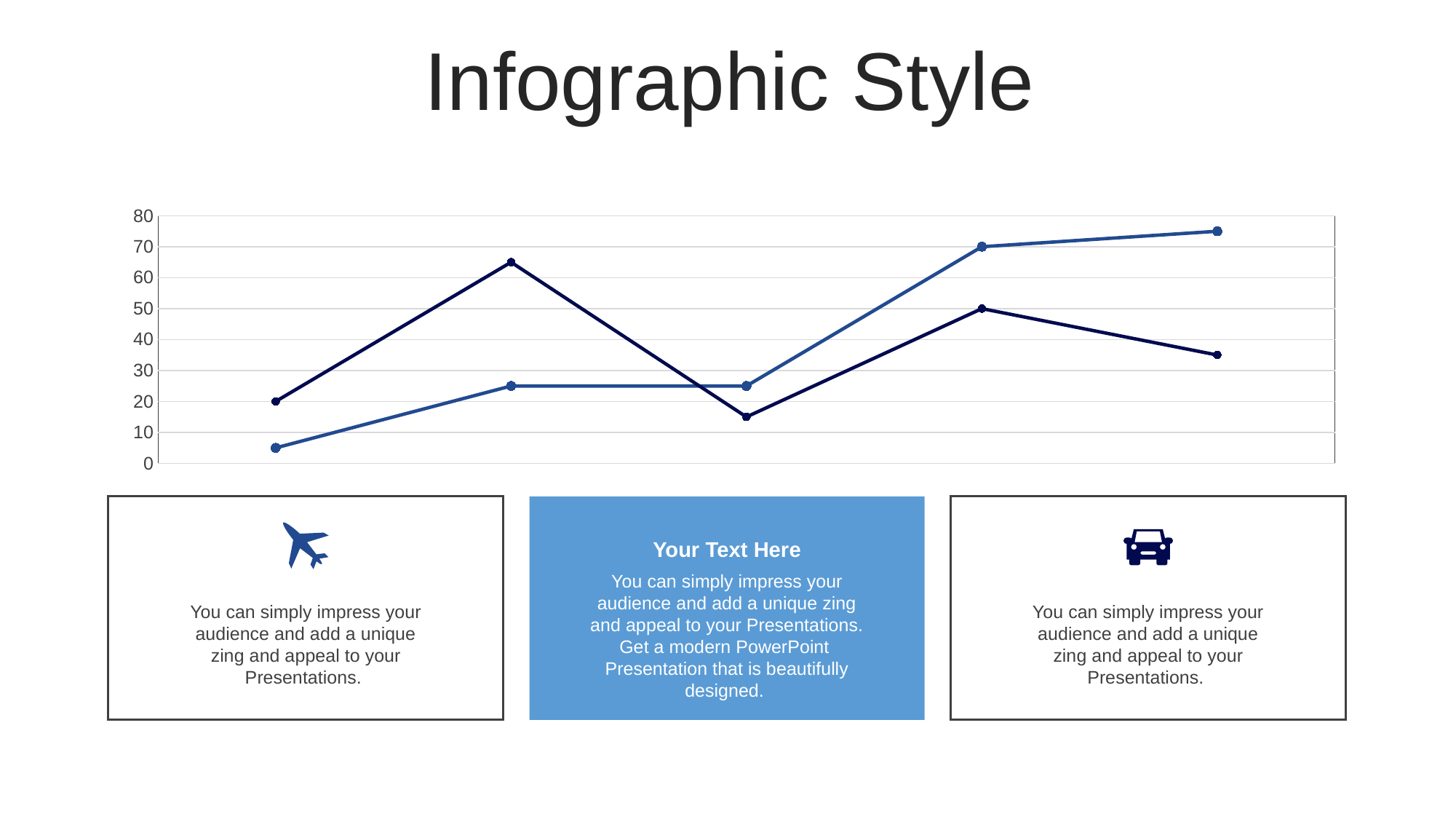
At the last (fifth) point, which line is higher, the dark navy line or the lighter blue line? the lighter blue line Which point on the lighter blue line is the highest? the fifth (last) point What is the value of the first point on the dark navy line? 20 Is the value of the second point on the dark navy line greater or less than 60? greater What is the value of the fourth point on the dark navy line? 50 How many lines are plotted on the chart? 2 Is the value of the first point on the lighter blue line greater or less than 10? less At the second point, which line is higher, the dark navy line or the lighter blue line? the dark navy line What is the value of the fourth point on the lighter blue line? 70 What kind of chart is shown on the slide? line chart How many data points does each line on the chart have? 5 Does the lighter blue line rise or fall overall from its first point to its last point? rise